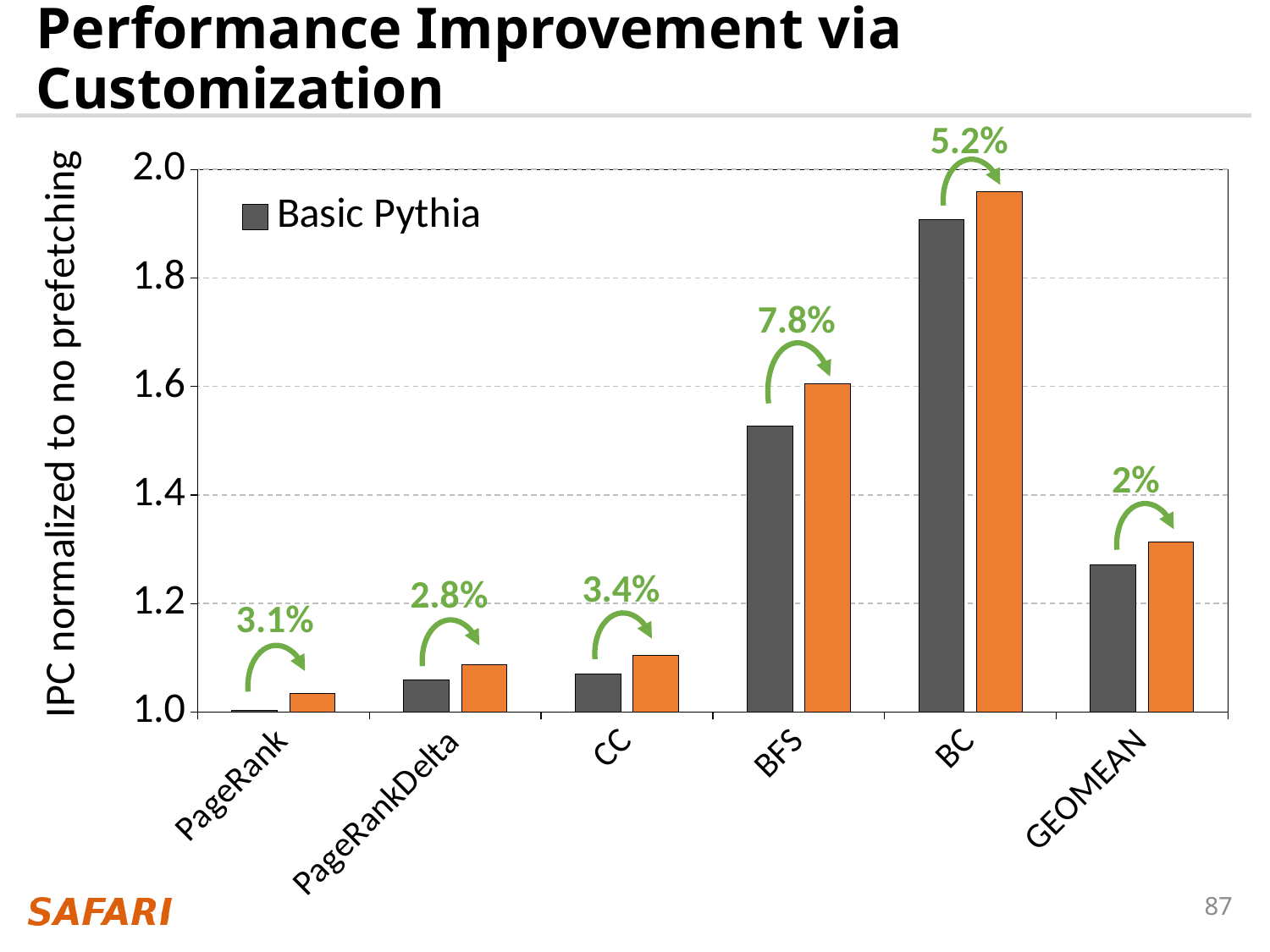
What is the percentage improvement shown above the PageRankDelta bars? 2.8% What is the percentage improvement shown above the GEOMEAN bars? 2% Which category has the lowest IPC values? PageRank Which category shows the largest percentage improvement label? BFS What is the label on the y axis of the chart? IPC normalized to no prefetching How many series does the chart's legend list? 1 How many categories are shown on the x axis of the chart? 6 What is the percentage improvement shown above the BFS bars? 7.8% Is the Basic Pythia value for BC greater or less than 1.8? greater What is the percentage improvement shown above the BC bars? 5.2% Which category has the highest IPC values? BC What kind of chart is shown on the slide? bar chart